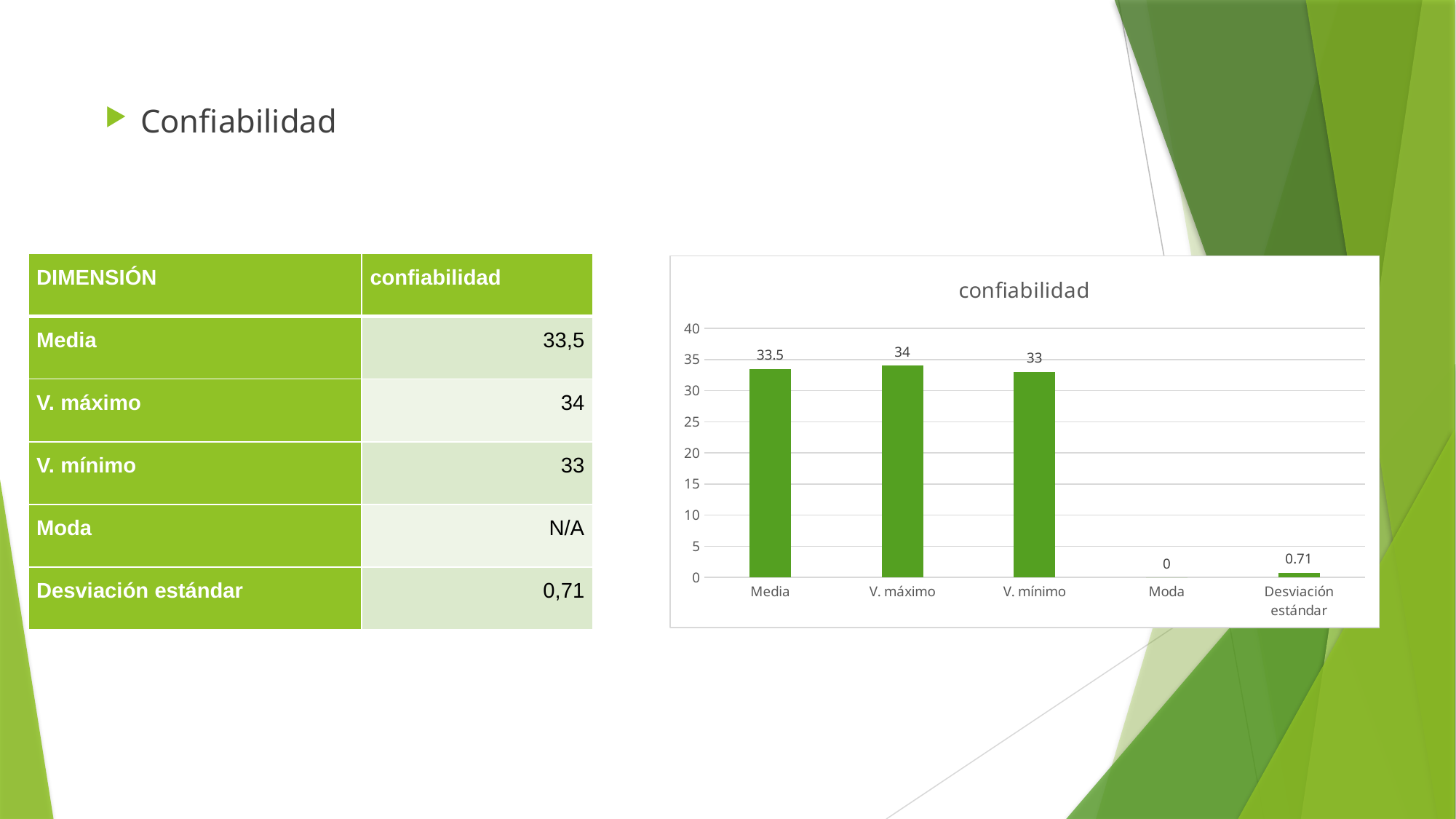
What is the value shown for Moda in the chart? 0 What is the value for Desviación estándar in the chart? 0.71 What kind of chart is shown on the slide? Bar chart What is the value for Media in the chart? 33.5 How many categories are shown on the x axis of the chart? 5 Which category has the highest value in the chart? V. máximo What is the value for V. mínimo in the chart? 33 Which category has the lowest value in the chart? Moda What is the value for V. máximo in the chart? 34 Which is larger, the value for Media or the value for V. mínimo? Media What is the title of the chart? confiabilidad What is the difference between the values for V. máximo and V. mínimo? 1